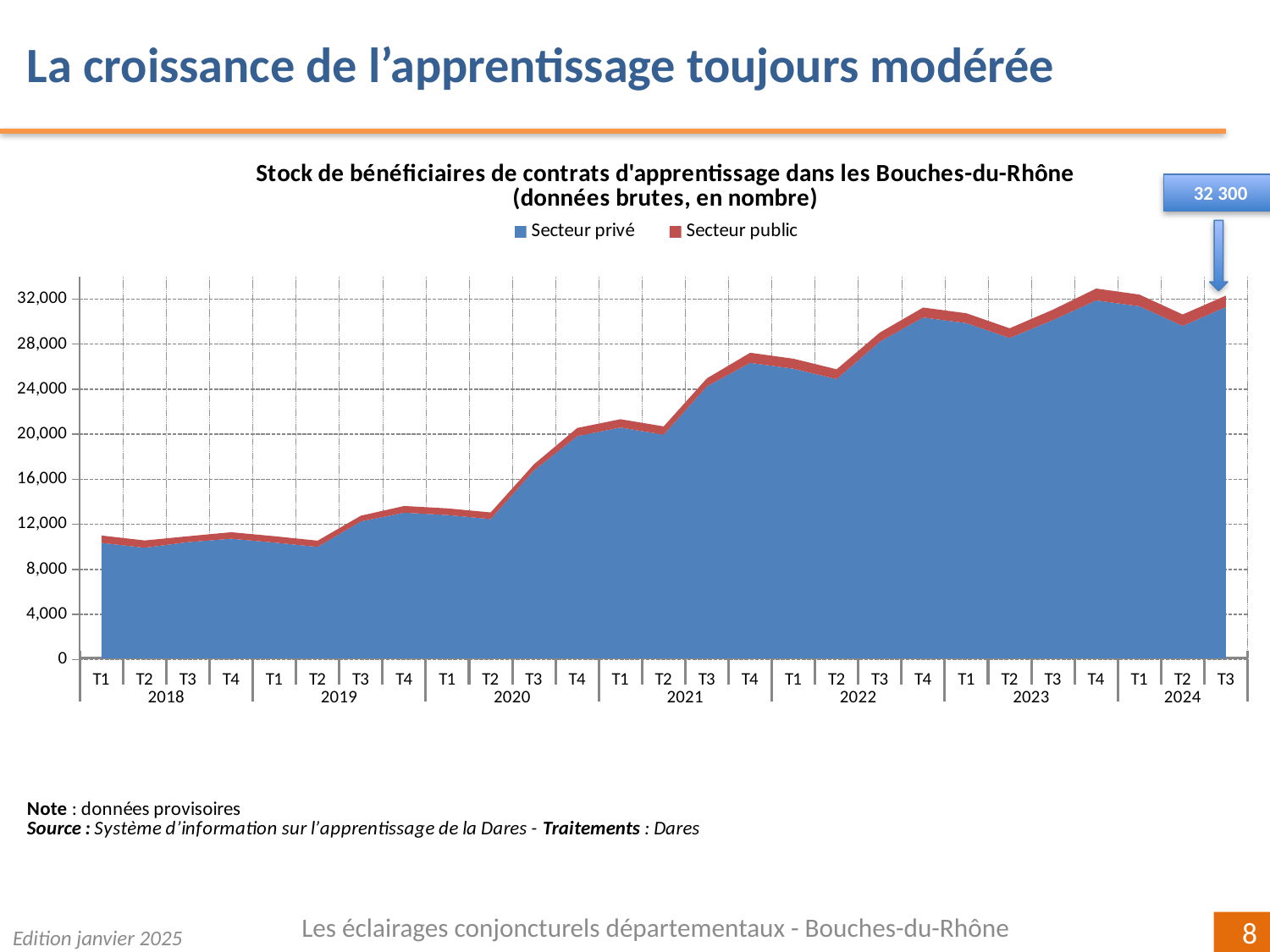
What total value is called out for T3 2024? 32 300 Is the total value for T1 2018 greater or less than 12,000? less Is the total value for T4 2021 greater or less than 24,000? greater Which is larger, the total for T4 2020 or the total for T4 2021? T4 2021 How many quarterly data points are plotted along the x axis? 27 Overall, do the values rise or fall from T1 2018 to T3 2024? Rise Is the total value for T2 2021 greater or less than 16,000? greater What are the two series named in the legend? Secteur privé and Secteur public Which colour represents Secteur public in the chart? Red What kind of chart is shown on the slide? Area chart How many series does the legend list? 2